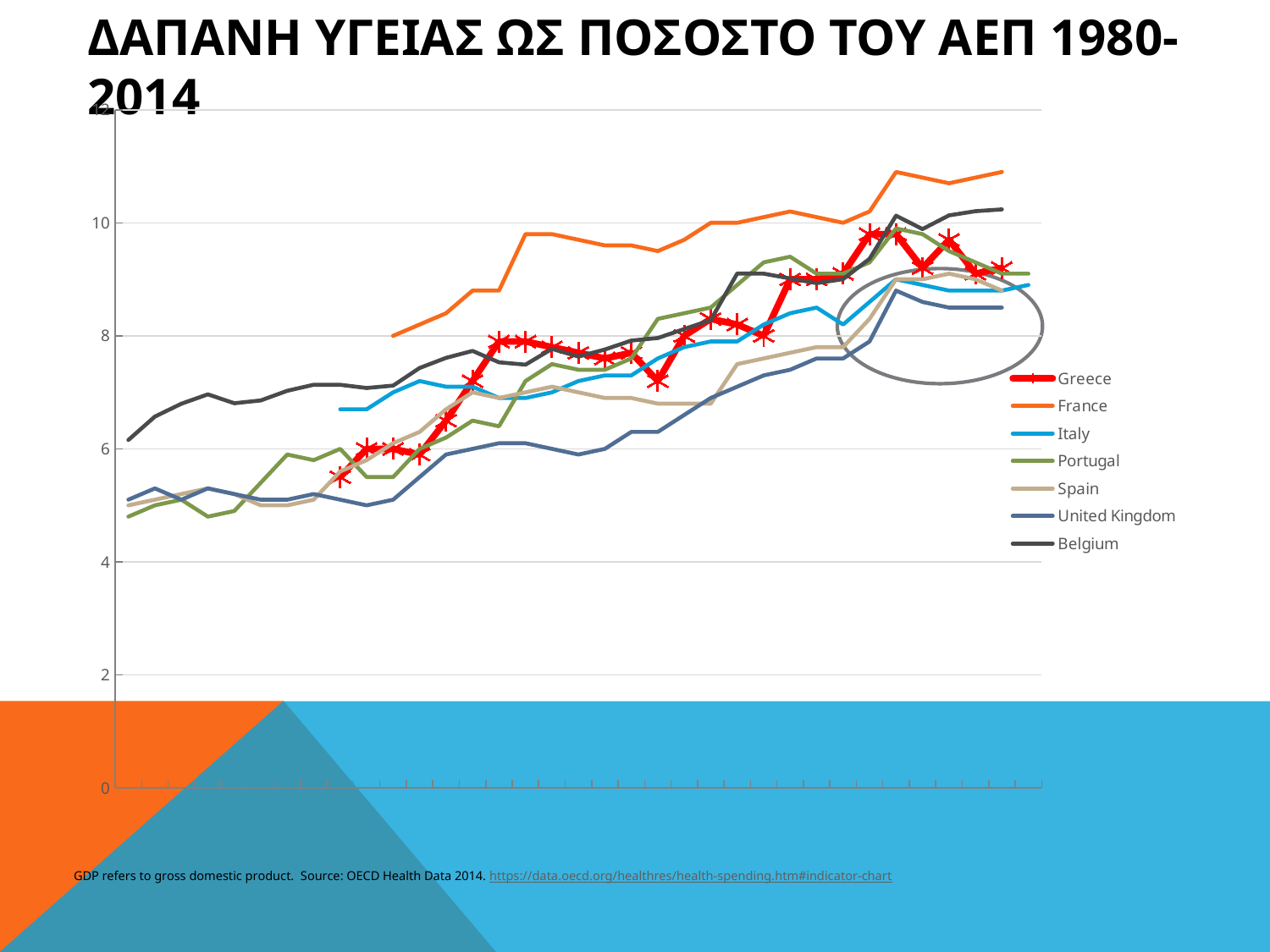
At the left end of the chart, which is larger: Belgium or Spain? Belgium How many series does the legend list? 7 At the right end of the chart, which is larger: France or United Kingdom? France Does the Greece series generally rise or fall from left to right? rise Which series has the lowest value at the right end of the chart? United Kingdom Is the value for Greece at the right end of the chart greater or less than 8? greater Which series is drawn in red with star markers? Greece What kind of chart is shown on the slide? line chart What is the title of the chart? ΔΑΠΑΝΗ ΥΓΕΙΑΣ ΩΣ ΠΟΣΟΣΤΟ ΤΟΥ ΑΕΠ 1980-2014 Is the highest value reached by France greater or less than 10? greater Is the value for United Kingdom at the left end of the chart greater or less than 6? less Which series has the highest value at the right end of the chart? France